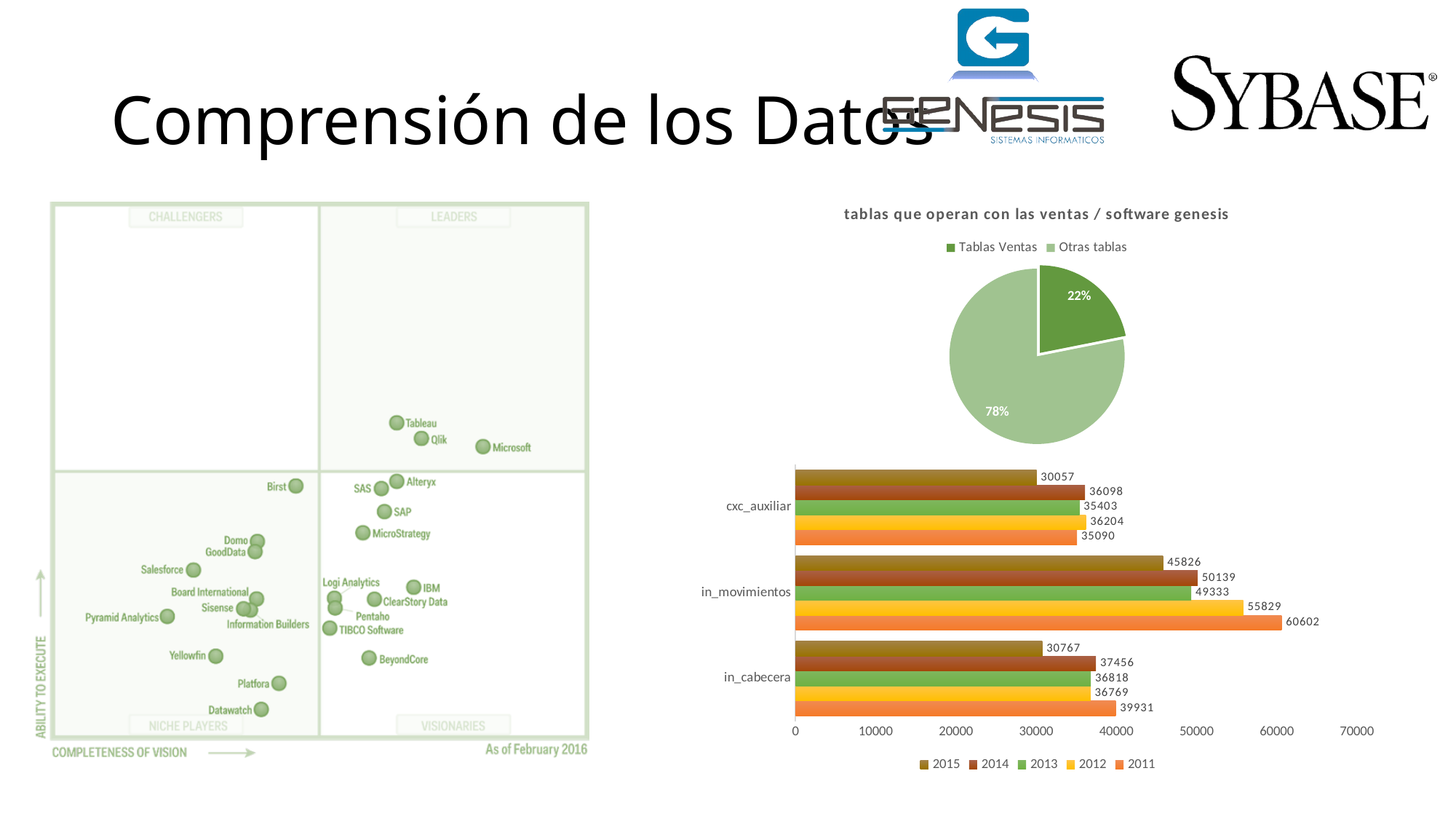
In the bar chart on the lower right, which is larger: the 2012 value for in_cabecera or the 2012 value for cxc_auxiliar? in_cabecera In the pie chart titled 'tablas que operan con las ventas / software genesis', what share is labelled for Otras tablas? 78% In the bar chart on the lower right, what is the value for in_cabecera in 2014? 37456 In the bar chart on the lower right, what is the difference between the 2011 and 2015 values for in_movimientos? 14776 In the bar chart on the lower right, what is the value for in_movimientos in 2011? 60602 In the bar chart on the lower right, how many categories are shown on the vertical axis? 3 In the bar chart on the lower right, which year has the highest value for in_movimientos? 2011 In the pie chart titled 'tablas que operan con las ventas / software genesis', what share is labelled for Tablas Ventas? 22% In the bar chart on the lower right, what is the value for cxc_auxiliar in 2015? 30057 In the pie chart titled 'tablas que operan con las ventas / software genesis', how many entries does the legend list? 2 In the bar chart on the lower right, how many series does the legend list? 5 What kind of chart is the lower chart on the right side of the slide? Bar chart